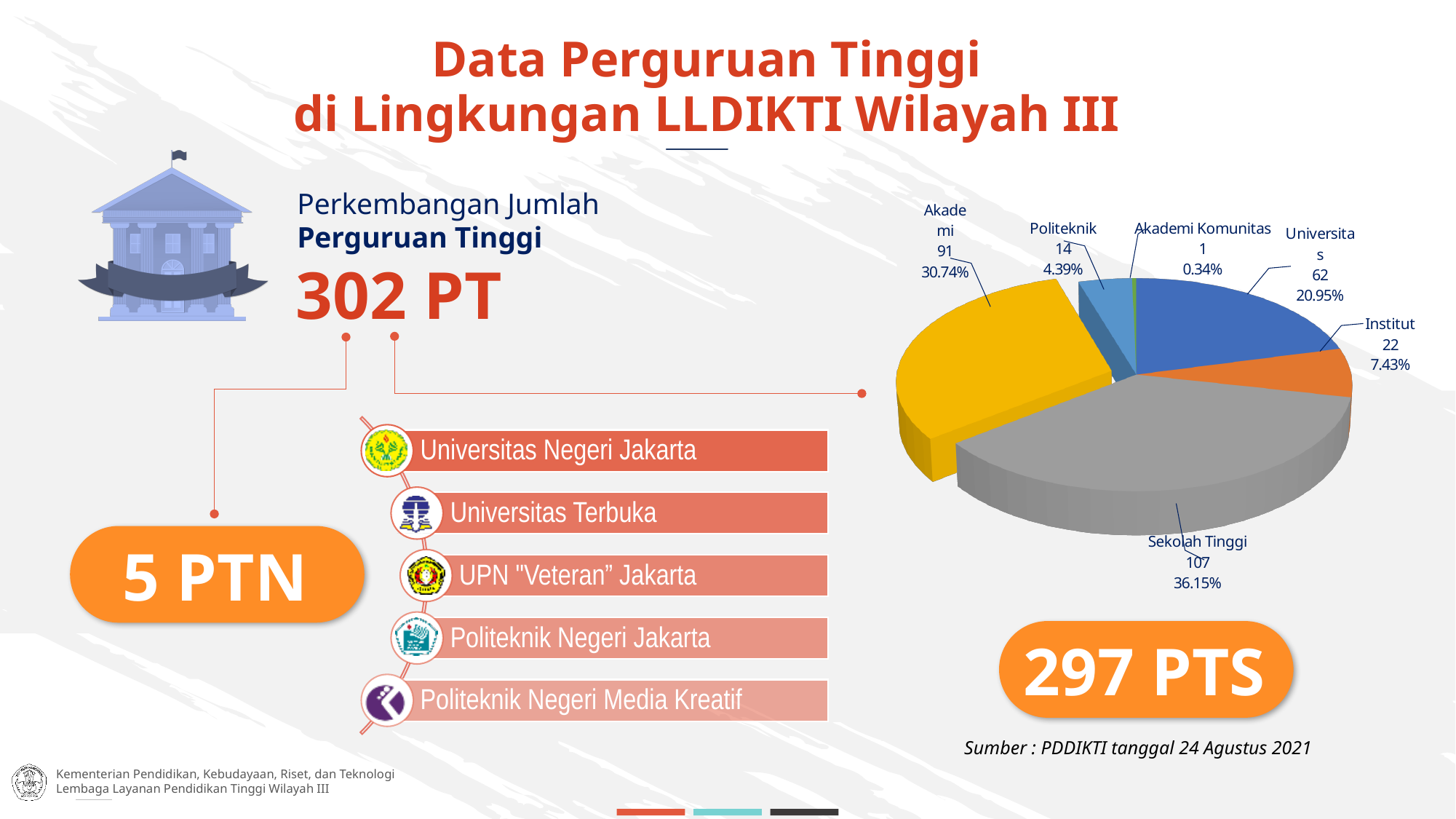
What percentage share does Institut have in the pie chart? 7.43% What is the value for Politeknik in the pie chart? 14 What is the value for Universitas in the pie chart? 62 What is the value for Sekolah Tinggi in the pie chart? 107 What kind of chart is shown on the slide? Pie chart Which category has the largest slice in the pie chart? Sekolah Tinggi How many categories does the pie chart show? 6 Which is larger in the pie chart, Politeknik or Institut? Institut What is the total of all the values in the pie chart? 297 What percentage share does Akademi have in the pie chart? 30.74% What is the difference between the values for Sekolah Tinggi and Akademi in the pie chart? 16 Which category has the smallest slice in the pie chart? Akademi Komunitas